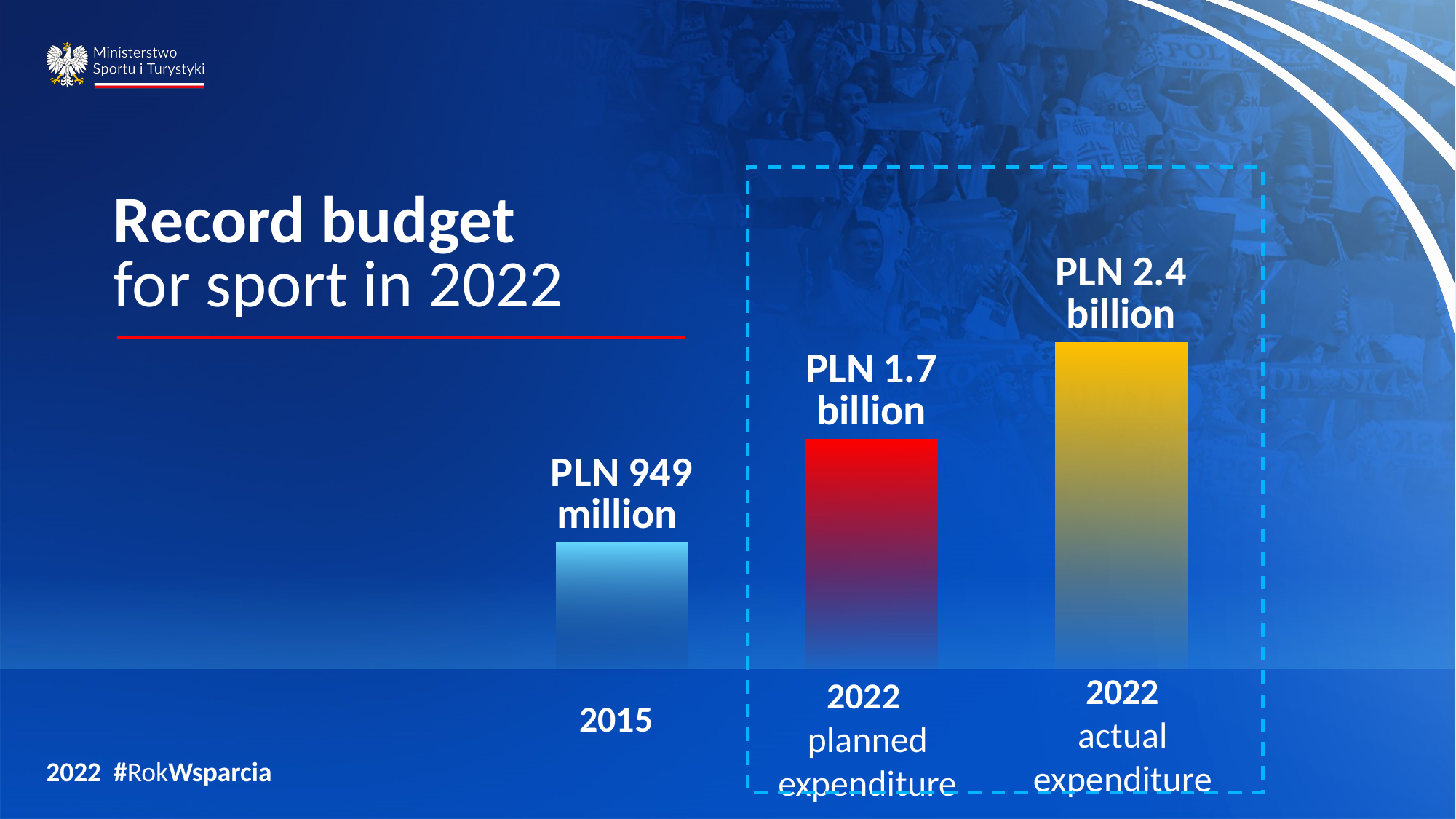
Which category has the lowest value? 2015 Which category has the highest value? 2022 actual expenditure What is the value shown for 2015? PLN 949 million Which is larger, the 2022 planned expenditure or the 2022 actual expenditure? 2022 actual expenditure Which is larger, the value for 2015 or the 2022 planned expenditure? 2022 planned expenditure What kind of chart is shown on the slide? Bar chart What is the value shown for 2022 actual expenditure? PLN 2.4 billion What is the difference between the 2022 actual expenditure and the 2022 planned expenditure? PLN 0.7 billion What is the value shown for 2022 planned expenditure? PLN 1.7 billion Do the values rise or fall from left to right across the bars? Rise What is the title of the slide containing the chart? Record budget for sport in 2022 How many bars are shown in the chart? 3